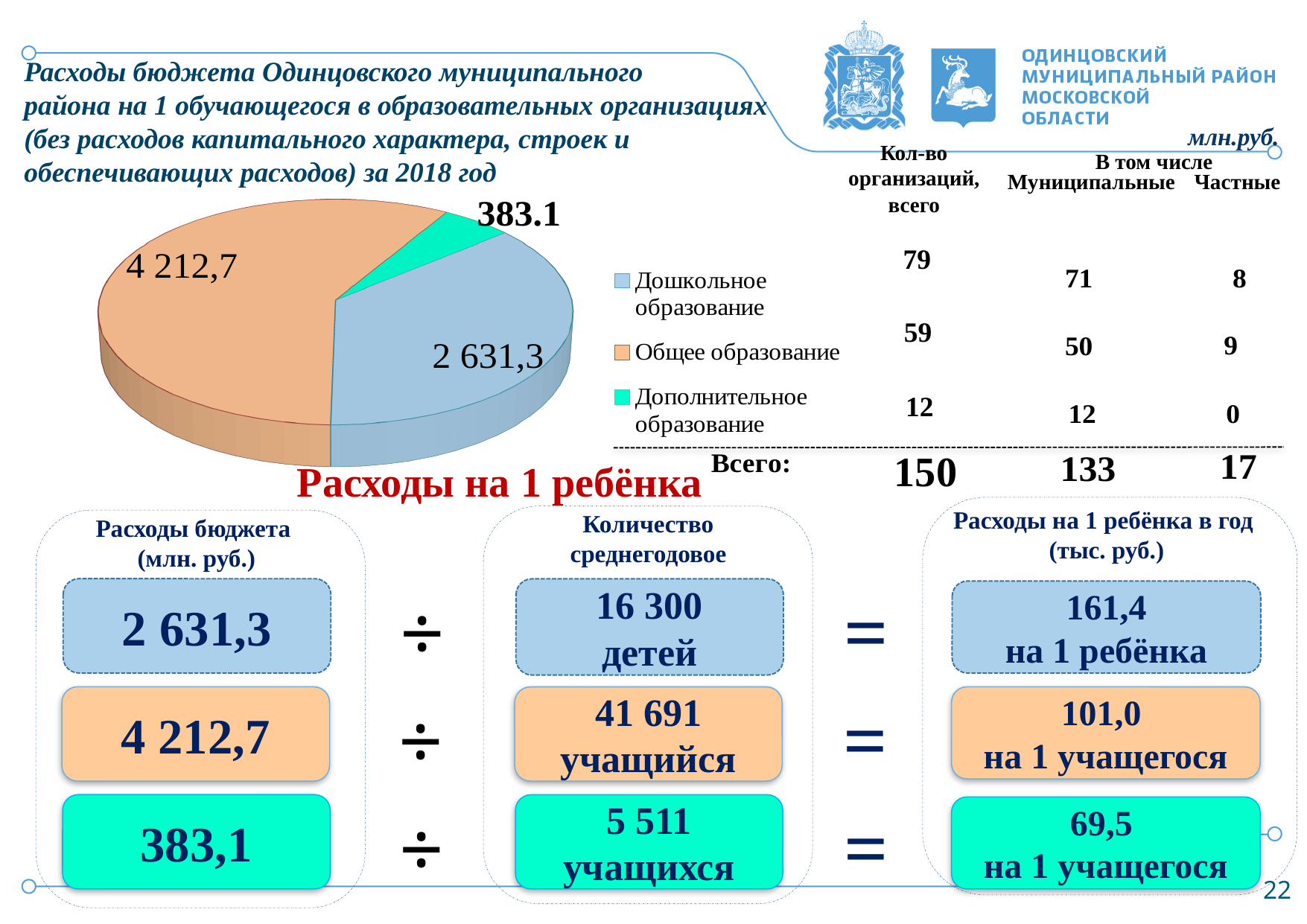
What is the total of all three values shown in the pie chart? 7 227,1 What is the difference between the pie chart values for Общее образование and Дошкольное образование? 1 581,4 How many entries does the pie chart legend list? 3 What value does the pie chart show for Дошкольное образование? 2 631,3 Which category has the smallest slice in the pie chart? Дополнительное образование What type of chart is shown on the slide? Pie chart What value does the pie chart show for Общее образование? 4 212,7 What value does the pie chart show for Дополнительное образование? 383.1 What colour is the Общее образование slice in the pie chart? Orange Which category has the largest slice in the pie chart? Общее образование How many slices does the pie chart have? 3 In the pie chart, which is larger: Дошкольное образование or Дополнительное образование? Дошкольное образование